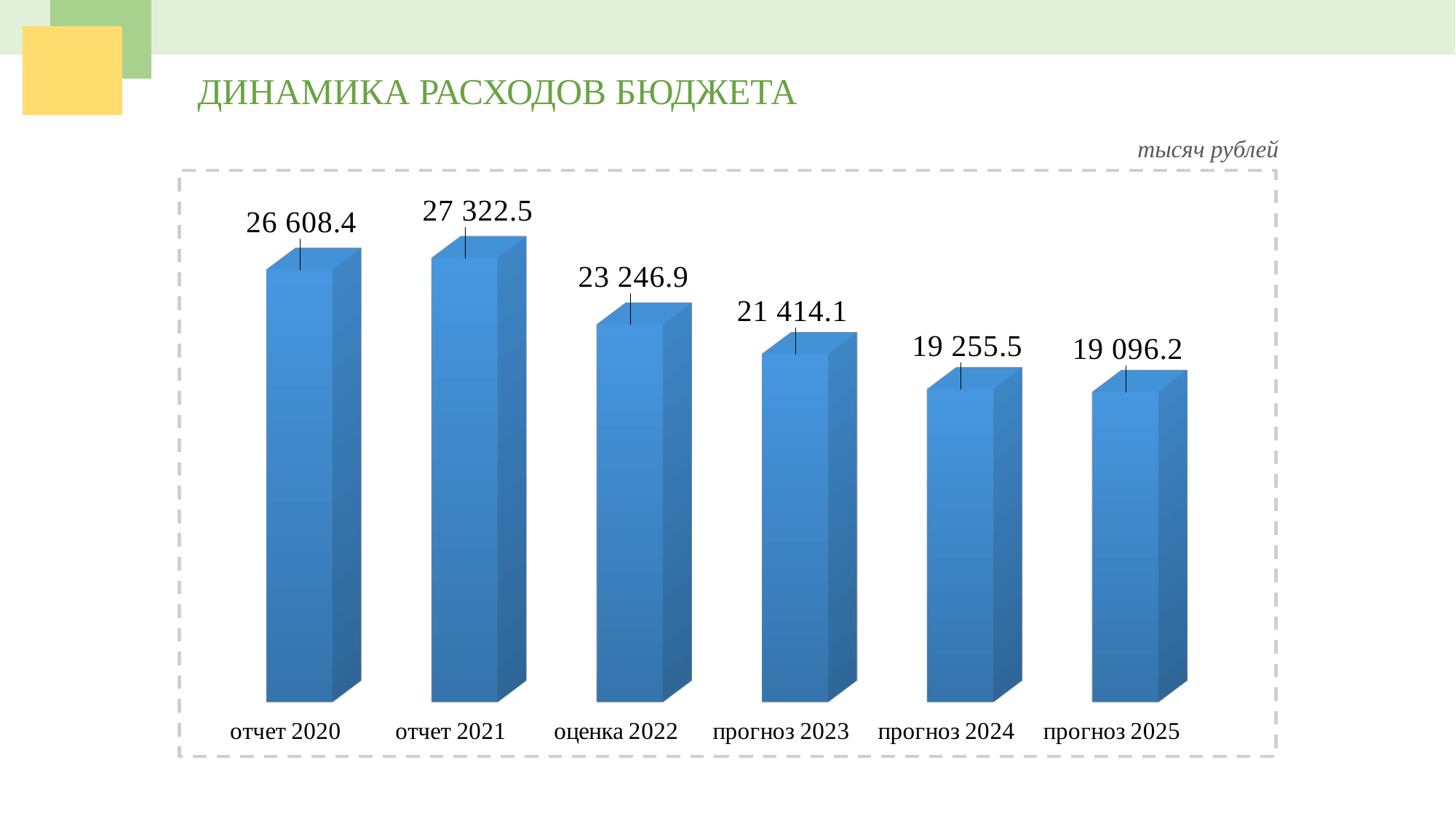
What is the value for прогноз 2025? 19 096.2 What is the difference between the highest and lowest values on the chart? 8 226.3 What is the difference between the values for отчет 2021 and отчет 2020? 714.1 What is the value for прогноз 2023? 21 414.1 What unit is indicated above the chart? тысяч рублей Which category has the lowest value? прогноз 2025 What kind of chart is shown on the slide? bar chart What is the value for отчет 2021? 27 322.5 Which category has the highest value? отчет 2021 What is the difference between the values for оценка 2022 and прогноз 2023? 1 832.8 How many categories are shown on the chart? 6 Which is larger, the value for отчет 2020 or the value for оценка 2022? отчет 2020